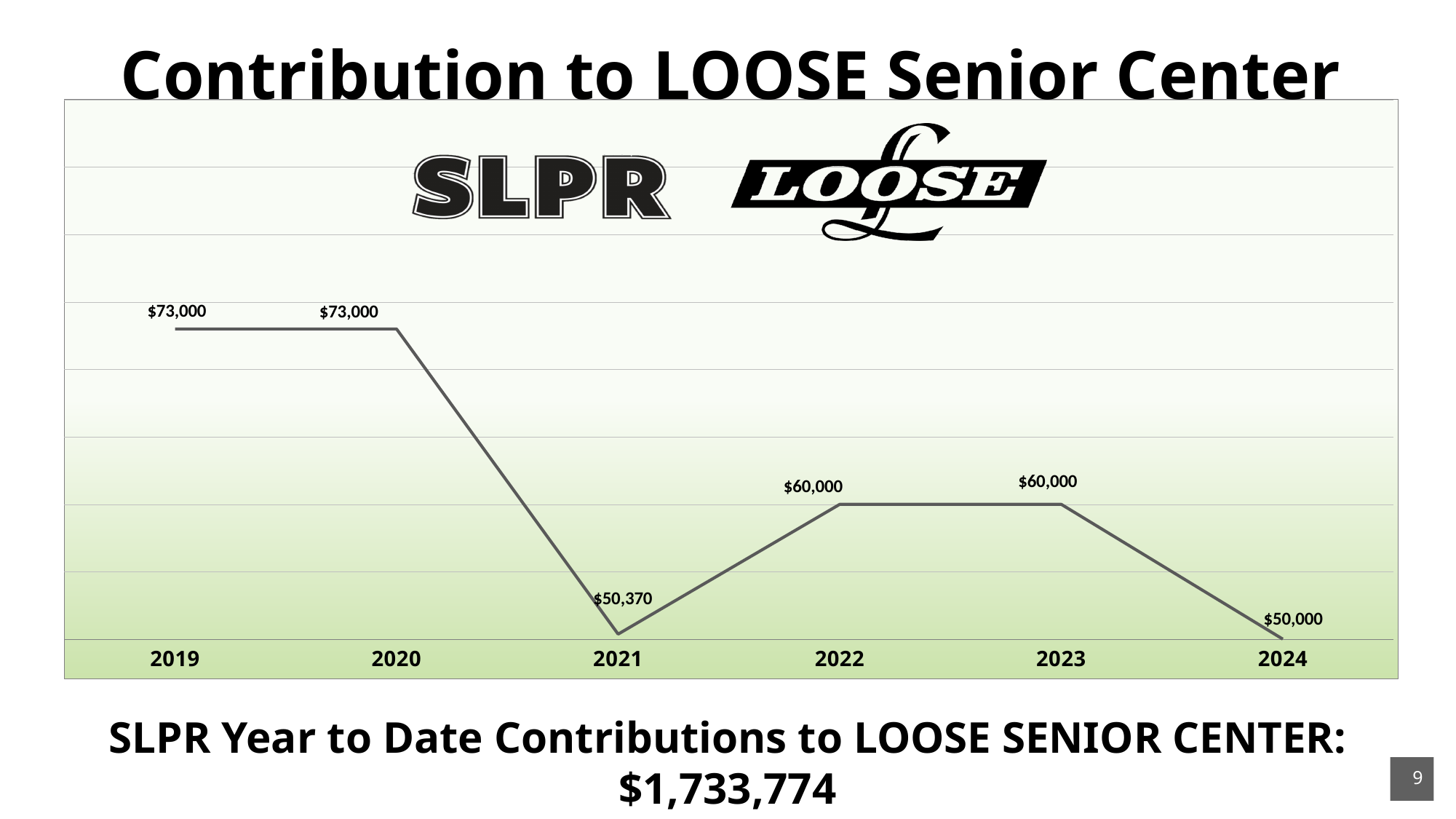
What is the title of the chart on the slide? Contribution to LOOSE Senior Center What was the contribution to LOOSE Senior Center in 2024? $50,000 What is the difference between the 2020 contribution and the 2021 contribution? $22,630 What is the SLPR year to date contribution total to LOOSE Senior Center stated on the slide? $1,733,774 Which year shows the lowest contribution on the chart? 2024 Which is larger, the contribution in 2021 or the contribution in 2022? 2022 What was the contribution to LOOSE Senior Center in 2021? $50,370 What was the contribution to LOOSE Senior Center in 2022? $60,000 What is the difference between the 2023 contribution and the 2024 contribution? $10,000 What kind of chart is shown on the slide? Line chart How many years are plotted on the chart? 6 Did the contribution rise or fall from 2020 to 2021? Fall